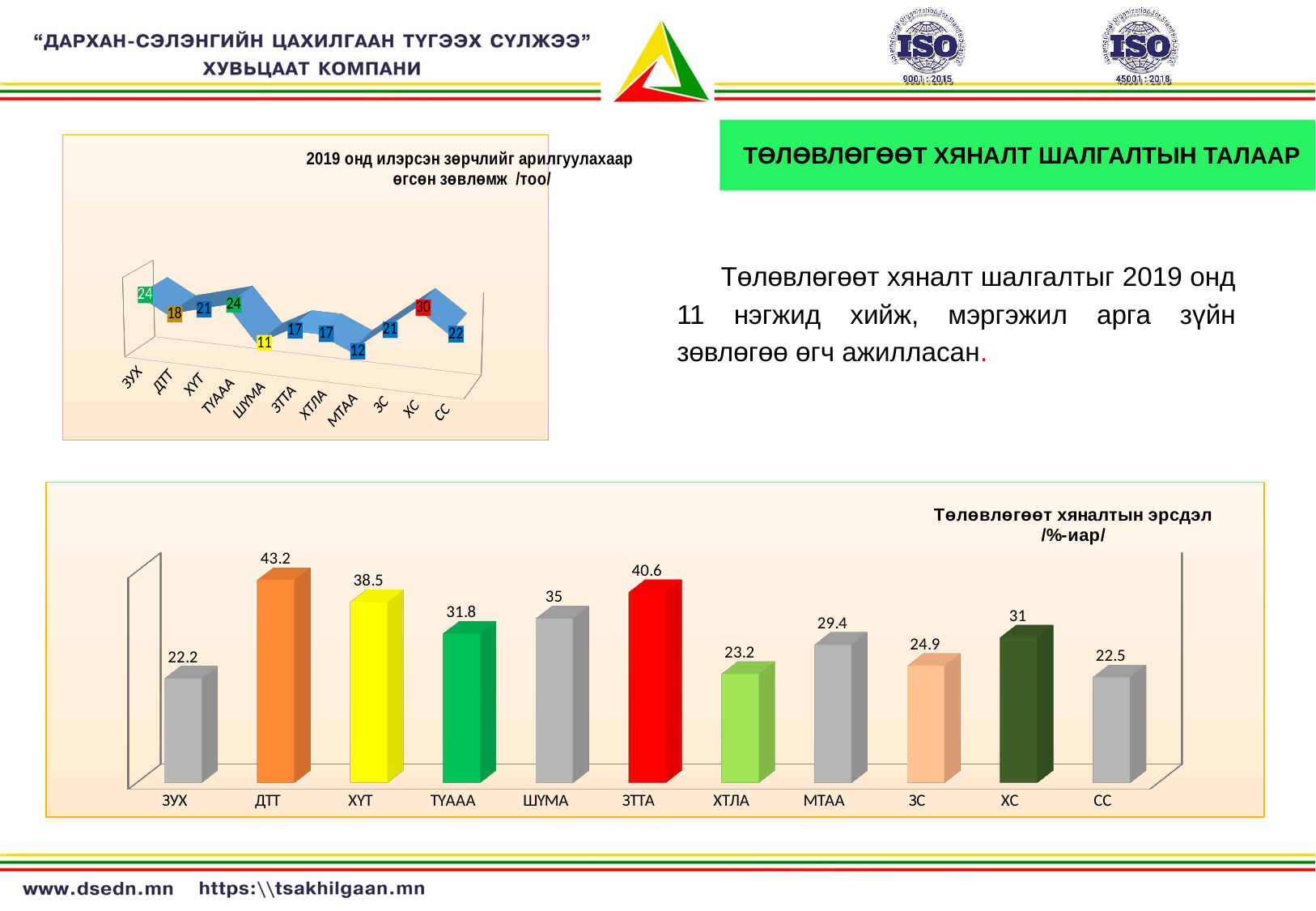
In the bottom chart 'Төлөвлөгөөт хяналтын эрсдэл /%-иар/', what is the value for ДТТ? 43.2 How many categories are shown in the bottom chart 'Төлөвлөгөөт хяналтын эрсдэл /%-иар/'? 11 What kind of chart is the bottom chart 'Төлөвлөгөөт хяналтын эрсдэл /%-иар/'? Bar chart In the bottom chart 'Төлөвлөгөөт хяналтын эрсдэл /%-иар/', which is larger, the value for ХҮТ or the value for ШҮМА? ХҮТ In the top-left chart '2019 онд илэрсэн зөрчлийг арилгуулахаар өгсөн зөвлөмж /тоо/', what is the difference between the values for ХС and МТАА? 18 In the bottom chart 'Төлөвлөгөөт хяналтын эрсдэл /%-иар/', what is the difference between the values for ЗТТА and ХТЛА? 17.4 In the bottom chart 'Төлөвлөгөөт хяналтын эрсдэл /%-иар/', which category has the lowest value? ЗУХ In the top-left chart '2019 онд илэрсэн зөрчлийг арилгуулахаар өгсөн зөвлөмж /тоо/', what is the value for ДТТ? 18 In the top-left chart '2019 онд илэрсэн зөрчлийг арилгуулахаар өгсөн зөвлөмж /тоо/', what is the value for ХС? 30 In the bottom chart 'Төлөвлөгөөт хяналтын эрсдэл /%-иар/', what is the value for ХС? 31 In the top-left chart '2019 онд илэрсэн зөрчлийг арилгуулахаар өгсөн зөвлөмж /тоо/', which category has the lowest value? ШҮМА In the bottom chart 'Төлөвлөгөөт хяналтын эрсдэл /%-иар/', which category has the highest value? ДТТ